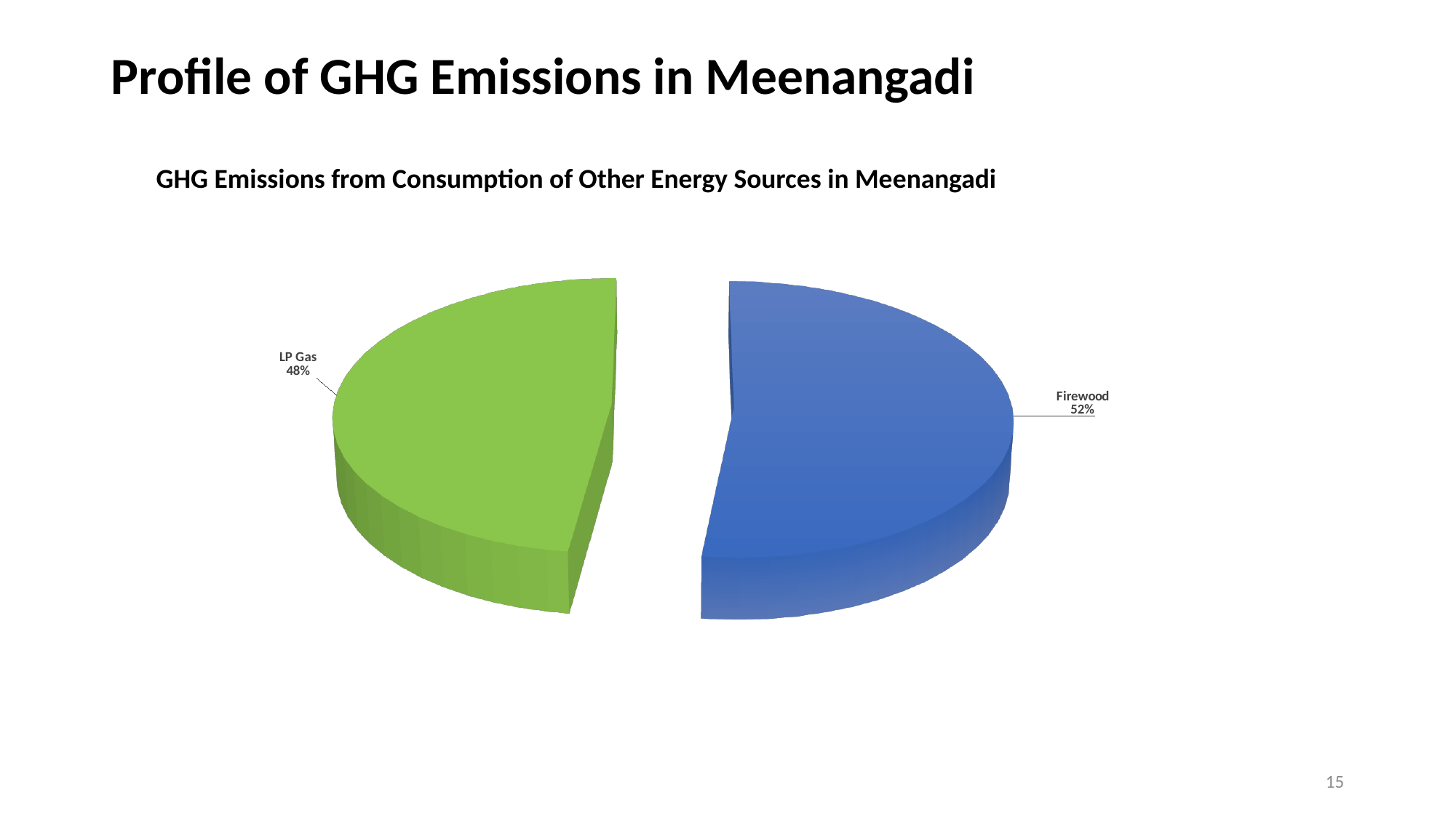
What is the title of the chart? GHG Emissions from Consumption of Other Energy Sources in Meenangadi Is the share for Firewood greater or less than 50%? greater What share of the pie does LP Gas account for? 48% Which is larger, the share for Firewood or the share for LP Gas? Firewood Is the share for LP Gas greater or less than 50%? less What is the difference in percentage points between the Firewood and LP Gas shares? 4 What share of the pie does Firewood account for? 52% Which category has the smallest share of the pie? LP Gas How many slices does the pie chart have? 2 What colour is the Firewood slice? Blue Which category has the largest share of the pie? Firewood What kind of chart is shown on the slide? Pie chart